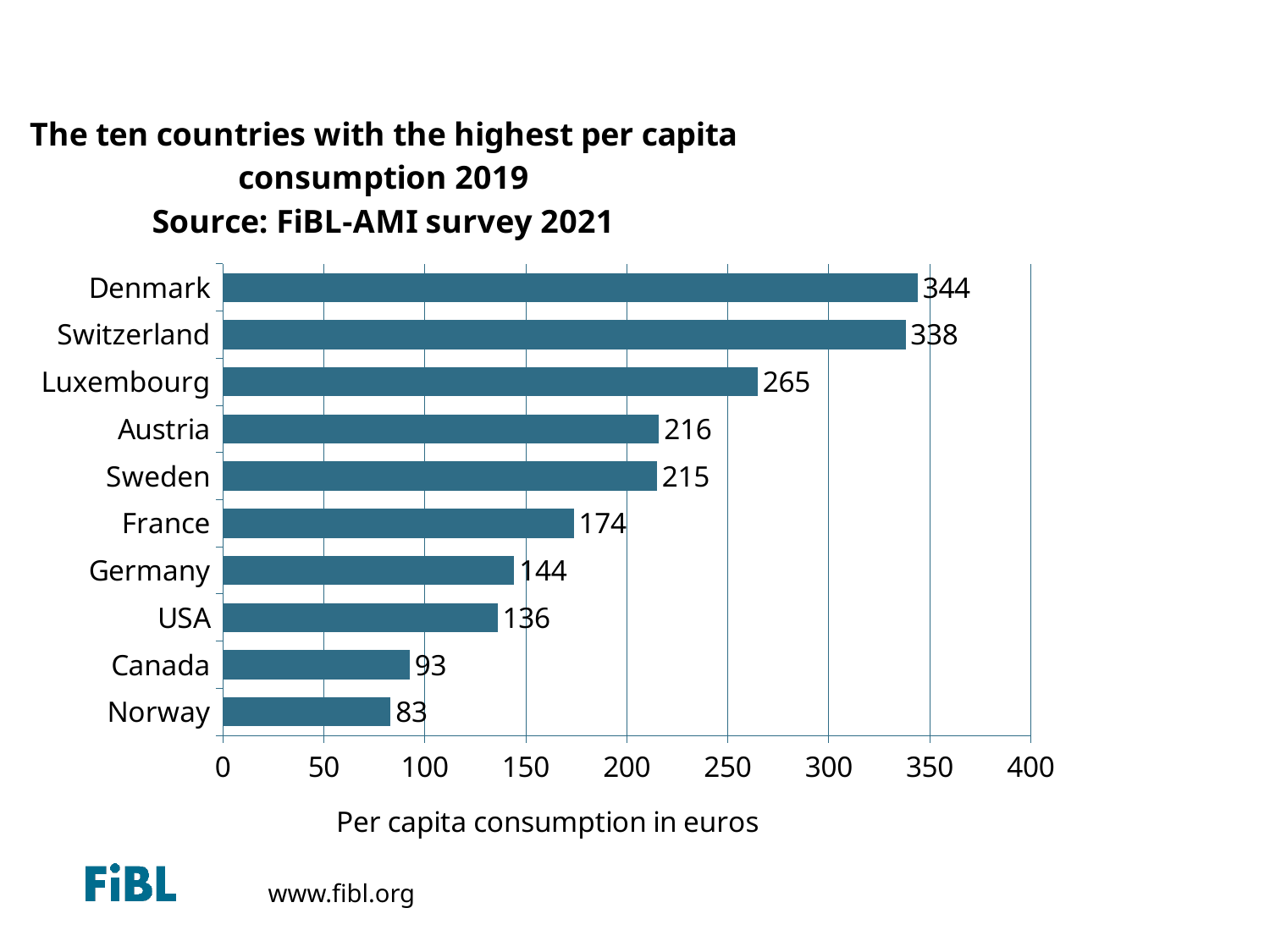
Which country has the lowest per capita consumption? Norway What is the per capita consumption for Germany? 144 What is the label of the horizontal axis? Per capita consumption in euros What is the per capita consumption for Canada? 93 Which has a higher per capita consumption, USA or Sweden? Sweden Is the value for France greater or less than 150? greater What is the difference between the per capita consumption of Luxembourg and France? 91 How many countries are shown in the chart? 10 What kind of chart is shown on the slide? Bar chart What is the per capita consumption for Denmark? 344 What is the difference between the per capita consumption of Denmark and Switzerland? 6 Which country has the highest per capita consumption? Denmark